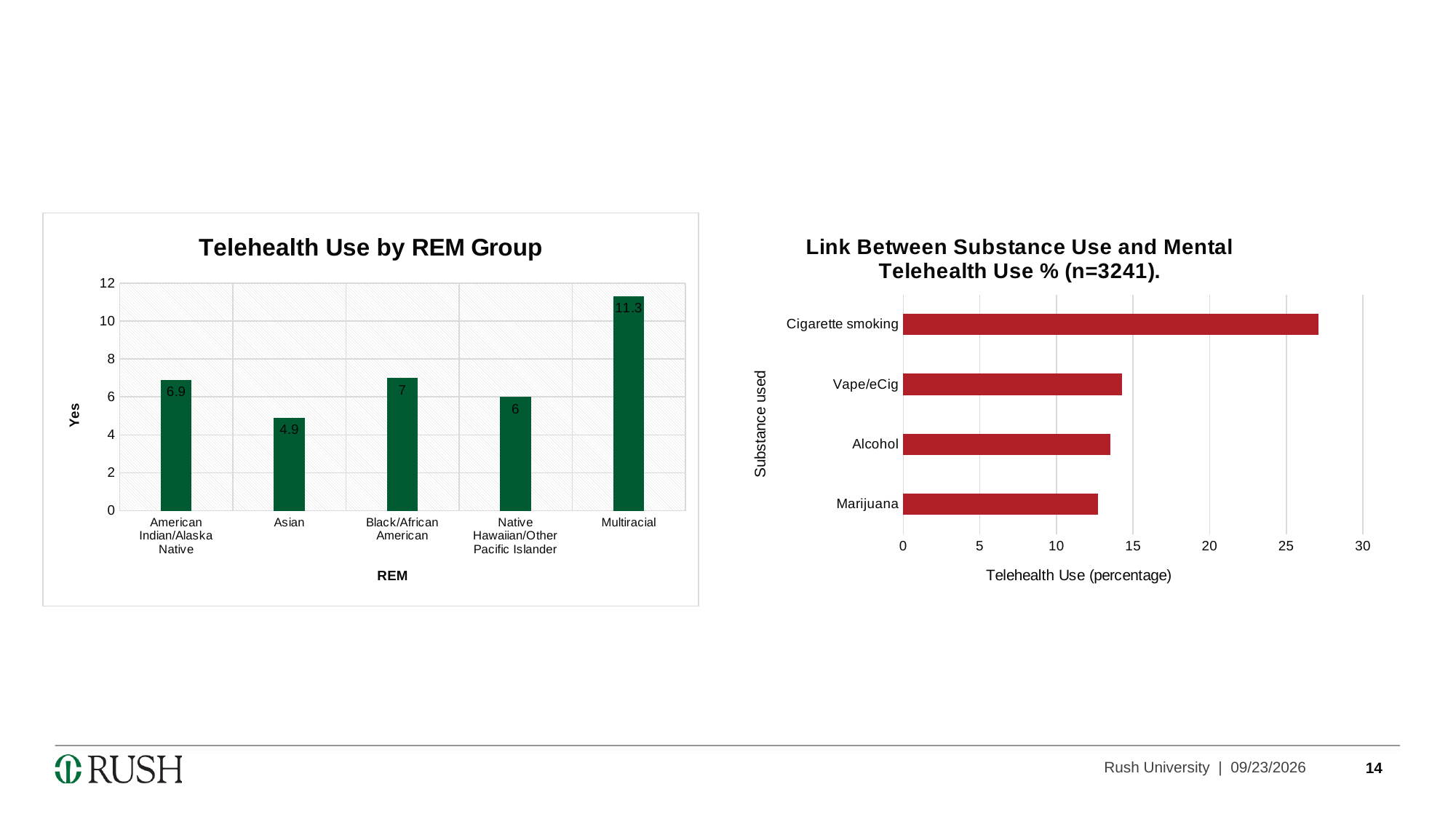
In the 'Link Between Substance Use and Mental Telehealth Use %' chart, is the value for Marijuana greater or less than 15? less In the 'Telehealth Use by REM Group' chart, what is the value for Multiracial? 11.3 What type of chart is the 'Link Between Substance Use and Mental Telehealth Use %' chart? Bar chart In the 'Telehealth Use by REM Group' chart, what is the value for Black/African American? 7 In the 'Telehealth Use by REM Group' chart, which REM group has the lowest value? Asian In the 'Link Between Substance Use and Mental Telehealth Use %' chart, how many substances are listed? 4 In the 'Telehealth Use by REM Group' chart, which REM group has the highest value? Multiracial In the 'Telehealth Use by REM Group' chart, what is the value for Asian? 4.9 In the 'Telehealth Use by REM Group' chart, how many REM groups are shown? 5 In the 'Link Between Substance Use and Mental Telehealth Use %' chart, which substance has the highest telehealth use percentage? Cigarette smoking In the 'Link Between Substance Use and Mental Telehealth Use %' chart, is the value for Cigarette smoking greater or less than 25? greater In the 'Telehealth Use by REM Group' chart, what is the difference between the values for Multiracial and American Indian/Alaska Native? 4.4